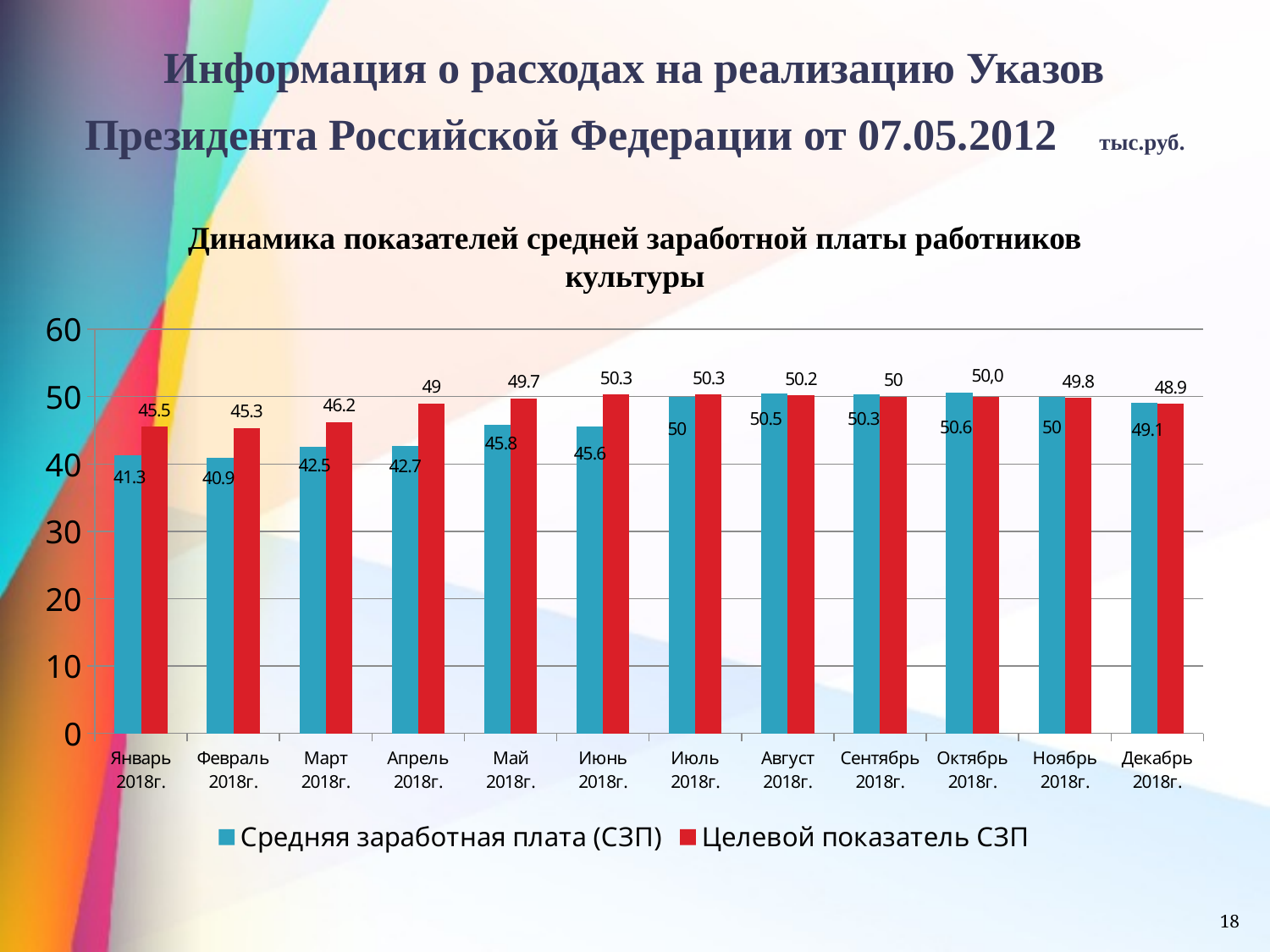
What is the value of Целевой показатель СЗП for Декабрь 2018г.? 48.9 Is the value of Средняя заработная плата (СЗП) for Март 2018г. greater or less than 50? less How many series does the legend list? 2 What is the difference between Целевой показатель СЗП and Средняя заработная плата (СЗП) for Январь 2018г.? 4.2 What is the value of Средняя заработная плата (СЗП) for Январь 2018г.? 41.3 In which month is Средняя заработная плата (СЗП) the lowest? Февраль 2018г. Does Средняя заработная плата (СЗП) rise or fall from Январь 2018г. to Июль 2018г.? rise In which month is Средняя заработная плата (СЗП) the highest? Октябрь 2018г. What is the value of Целевой показатель СЗП for Апрель 2018г.? 49 How many months are shown on the x axis? 12 What kind of chart is shown on the slide? bar chart For Июнь 2018г., which is larger: Средняя заработная плата (СЗП) or Целевой показатель СЗП? Целевой показатель СЗП